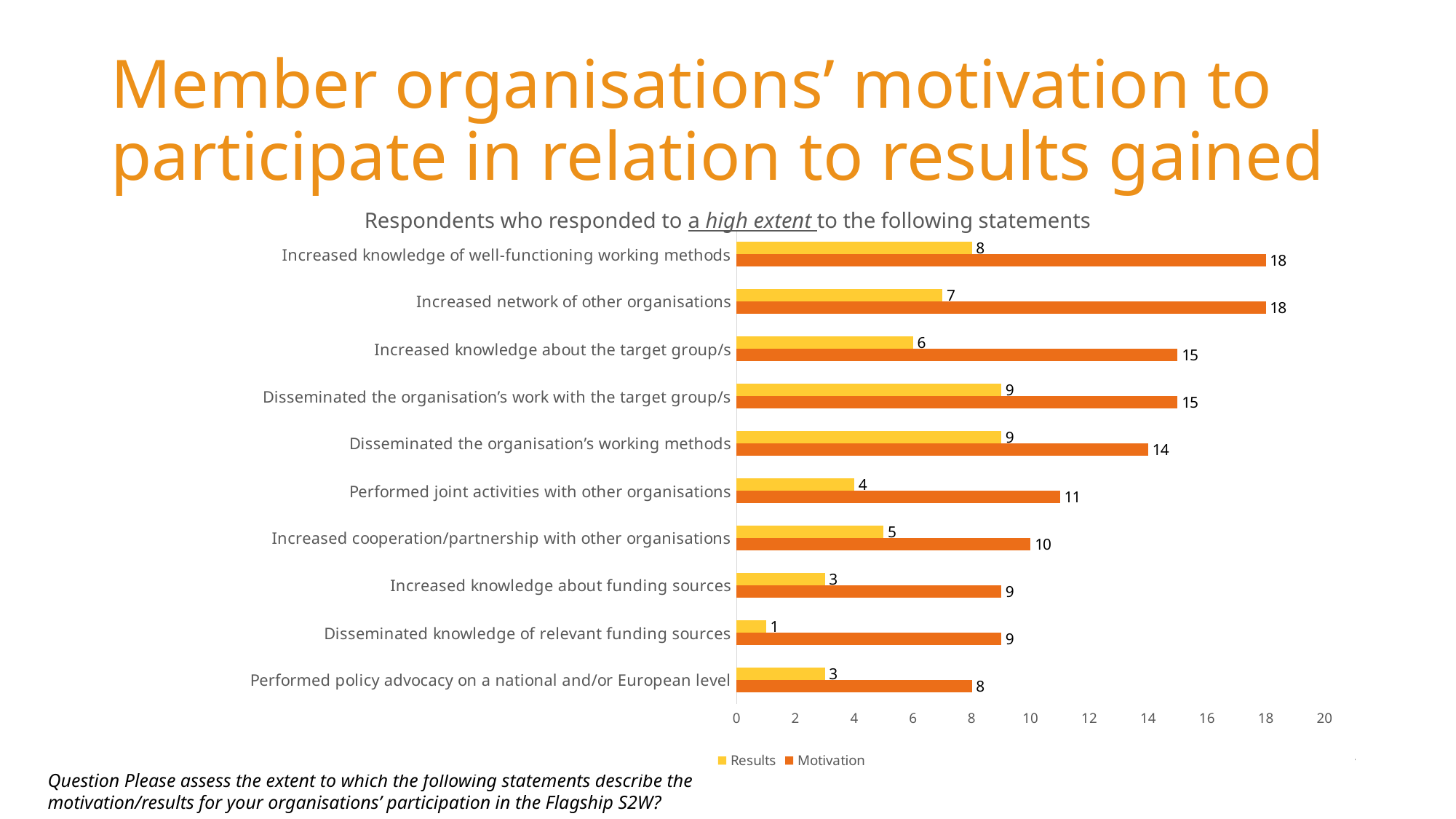
What is the difference between the Motivation and Results values for "Increased knowledge of well-functioning working methods"? 10 Which is larger: the Results value for "Disseminated the organisation's working methods" or the Results value for "Increased cooperation/partnership with other organisations"? Disseminated the organisation's working methods Which category has the lowest Motivation value? Performed policy advocacy on a national and/or European level What is the Results value for "Disseminated knowledge of relevant funding sources"? 1 What is the maximum value shown on the horizontal axis? 20 How many series does the legend list? 2 What is the Results value for "Performed joint activities with other organisations"? 4 Which series is shown in the darker orange colour? Motivation Which category has the lowest Results value? Disseminated knowledge of relevant funding sources What kind of chart is shown on the slide? Bar chart How many categories (statements) are shown on the chart? 10 What is the Motivation value for "Increased knowledge about the target group/s"? 15